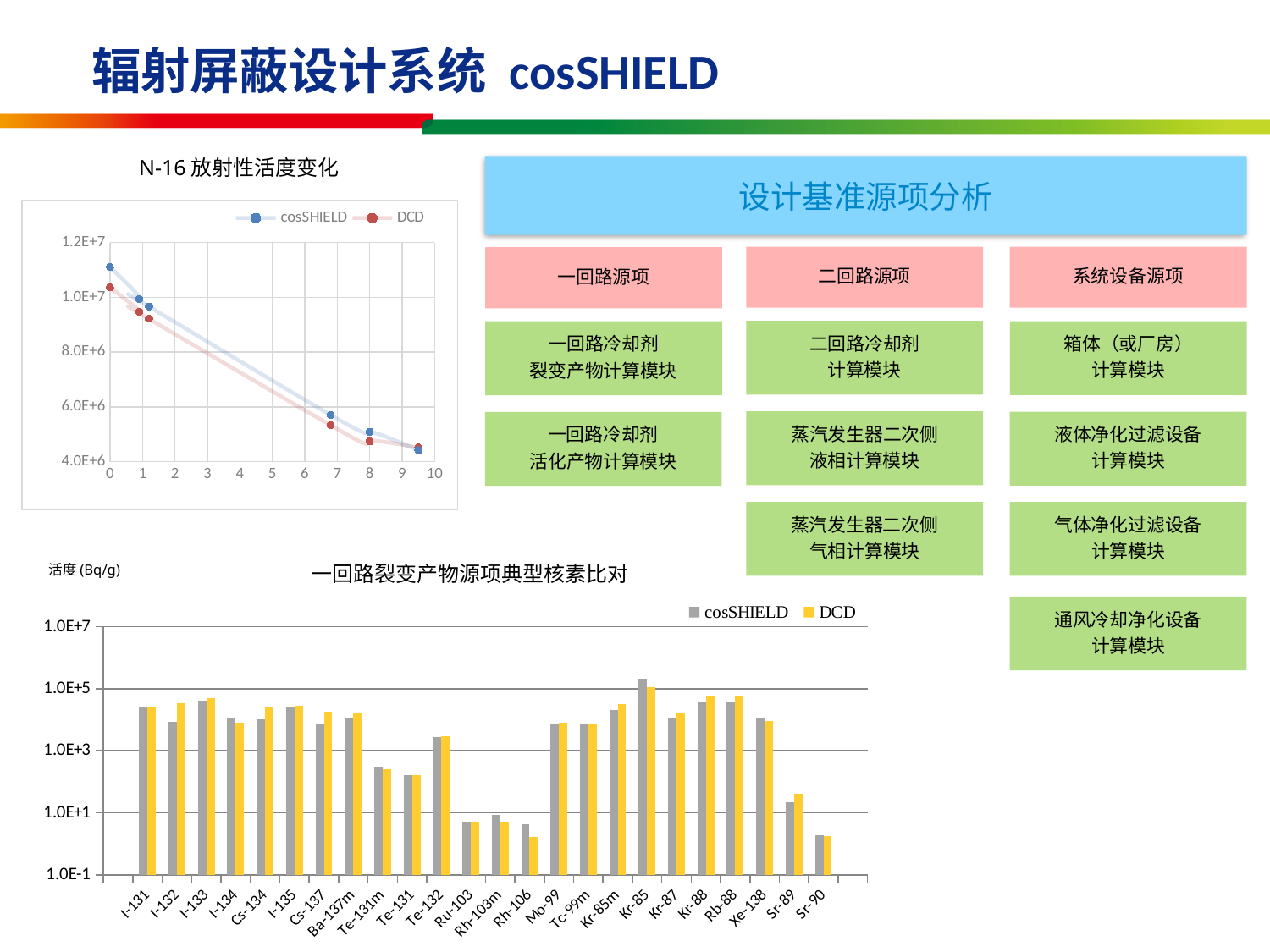
In the 一回路裂变产物源项典型核素比对 chart, is the DCD value for Ru-103 greater or less than 1.0E+1? less What type of chart is the chart titled 一回路裂变产物源项典型核素比对? bar chart In the 一回路裂变产物源项典型核素比对 chart, is the cosSHIELD value for Kr-85 greater or less than 1.0E+5? greater How many series does the legend of the N-16 放射性活度变化 chart list? 2 In the N-16 放射性活度变化 chart, is the cosSHIELD value at x = 0 greater or less than 1.0E+7? greater In the 一回路裂变产物源项典型核素比对 chart, which series has the larger value for Sr-89, cosSHIELD or DCD? DCD In the 一回路裂变产物源项典型核素比对 chart, which nuclide has the lowest cosSHIELD value? Sr-90 How many nuclide categories are shown on the x axis of the 一回路裂变产物源项典型核素比对 chart? 24 In the 一回路裂变产物源项典型核素比对 chart, which nuclide has the highest cosSHIELD value? Kr-85 In the N-16 放射性活度变化 chart, do the values rise or fall as x increases from 0 to 10? fall What type of chart is the chart titled N-16 放射性活度变化? line chart